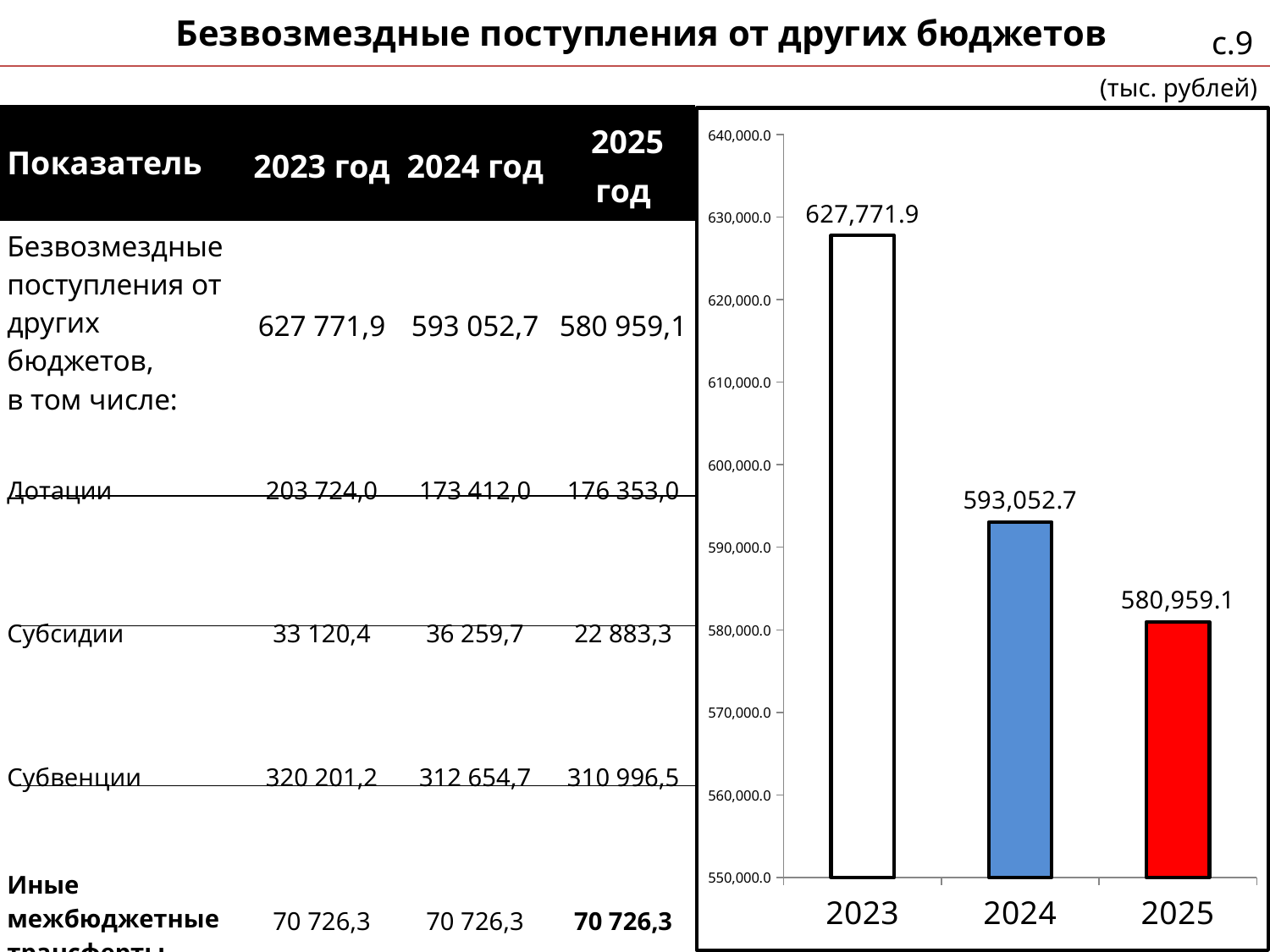
What is the value of the bar for 2024? 593,052.7 Do the values rise or fall from 2023 to 2025? fall What is the value of the bar for 2023? 627,771.9 Is the value for 2025 greater or less than 590,000.0? less What kind of chart is shown on the slide? bar chart What is the difference between the values for 2024 and 2025? 12,093.6 How many bars are shown in the chart? 3 Which year has the lowest bar? 2025 Which is larger, the value for 2024 or the value for 2025? 2024 What is the difference between the values for 2023 and 2024? 34,719.2 Which year has the highest bar? 2023 What is the value of the bar for 2025? 580,959.1